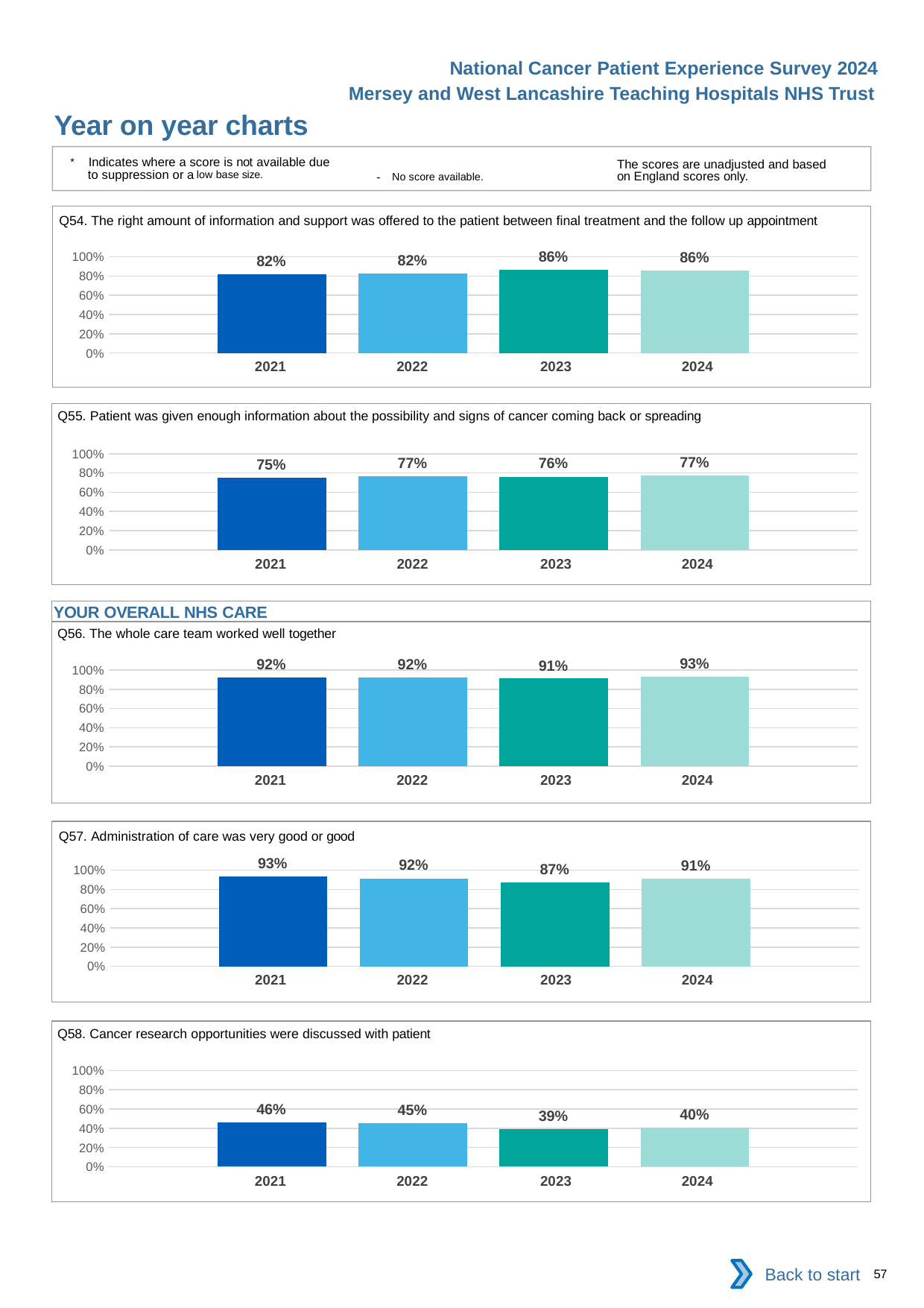
In the Q58 chart, what is the difference between the 2021 and 2023 values? 7% In the Q57 chart, is the value for 2021 or 2023 larger? 2021 In the Q54 chart, what is the difference between the 2023 and 2021 values? 4% What kind of chart is the Q56 chart? bar chart In the Q57 chart, which year has the lowest value? 2023 In the Q58 chart, do the values generally rise or fall from 2021 to 2024? fall In the Q56 chart, which year has the highest value? 2024 How many years are shown in the Q54 chart? 4 In the Q54 chart, what is the value for 2024? 86% In the Q55 chart, what is the value for 2021? 75% What is the title of the chart directly below the heading 'YOUR OVERALL NHS CARE'? Q56. The whole care team worked well together In the Q58 chart, is the value for 2024 greater or less than 60%? less